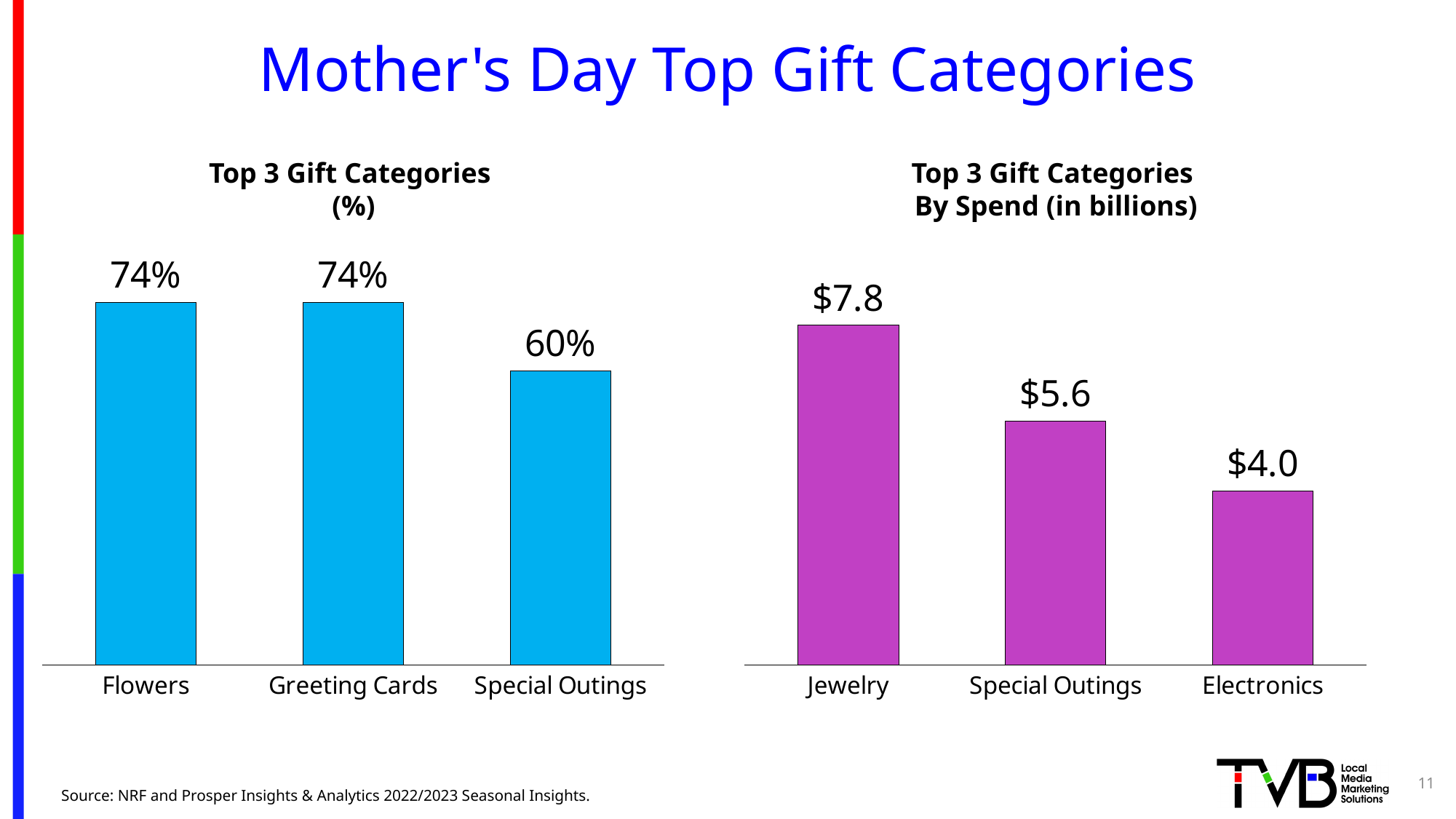
In the 'Top 3 Gift Categories By Spend (in billions)' chart, what is the difference between Jewelry and Special Outings? $2.2 In the 'Top 3 Gift Categories (%)' chart, which category has the lowest value? Special Outings In the 'Top 3 Gift Categories (%)' chart, what is the difference between Greeting Cards and Special Outings? 14% What kind of chart is the 'Top 3 Gift Categories By Spend (in billions)' chart? bar chart In the 'Top 3 Gift Categories By Spend (in billions)' chart, which category has the highest spend? Jewelry In the 'Top 3 Gift Categories (%)' chart, what is the value for Special Outings? 60% In the 'Top 3 Gift Categories By Spend (in billions)' chart, do the values rise or fall from left to right? fall In the 'Top 3 Gift Categories (%)' chart, how many categories are shown? 3 In the 'Top 3 Gift Categories By Spend (in billions)' chart, which is larger, Special Outings or Electronics? Special Outings In the 'Top 3 Gift Categories By Spend (in billions)' chart, what is the value for Electronics? $4.0 In the 'Top 3 Gift Categories (%)' chart, what is the value for Flowers? 74% In the 'Top 3 Gift Categories By Spend (in billions)' chart, what is the value for Jewelry? $7.8